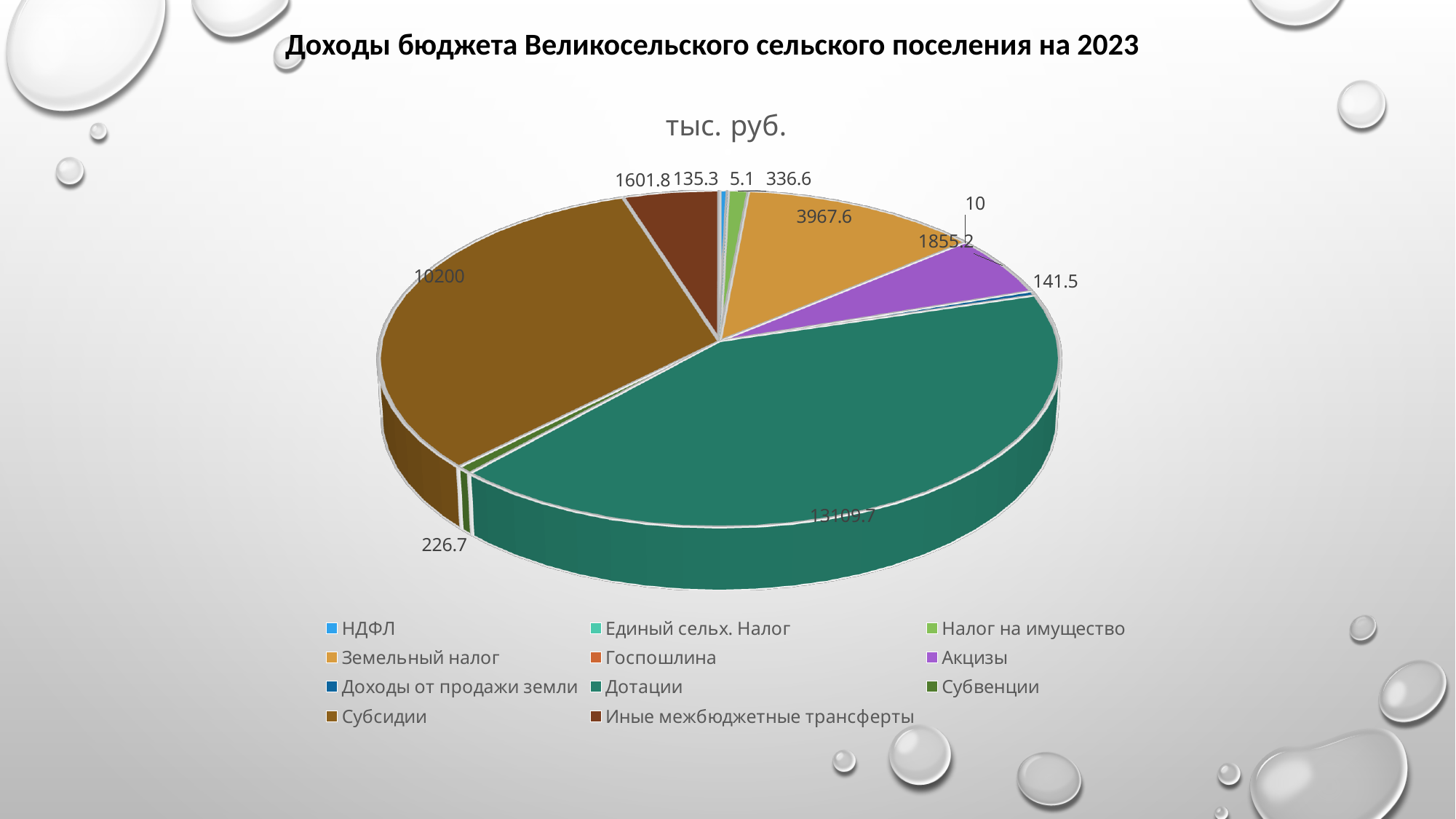
What is the value for Акцизы? 1855.2 What unit is given in the chart title above the pie? тыс. руб. What is the value for Субвенции? 226.7 What is the value for Земельный налог? 3967.6 What kind of chart is shown on the slide? pie chart What is the difference between the values for Дотации and Субсидии? 2909.7 What is the value for Субсидии? 10200 What is the value for Иные межбюджетные трансферты? 1601.8 Which category has the largest slice of the pie? Дотации What is the value for Дотации? 13109.7 Which is larger, the value for Земельный налог or the value for Акцизы? Земельный налог How many categories does the legend of the pie chart list? 11